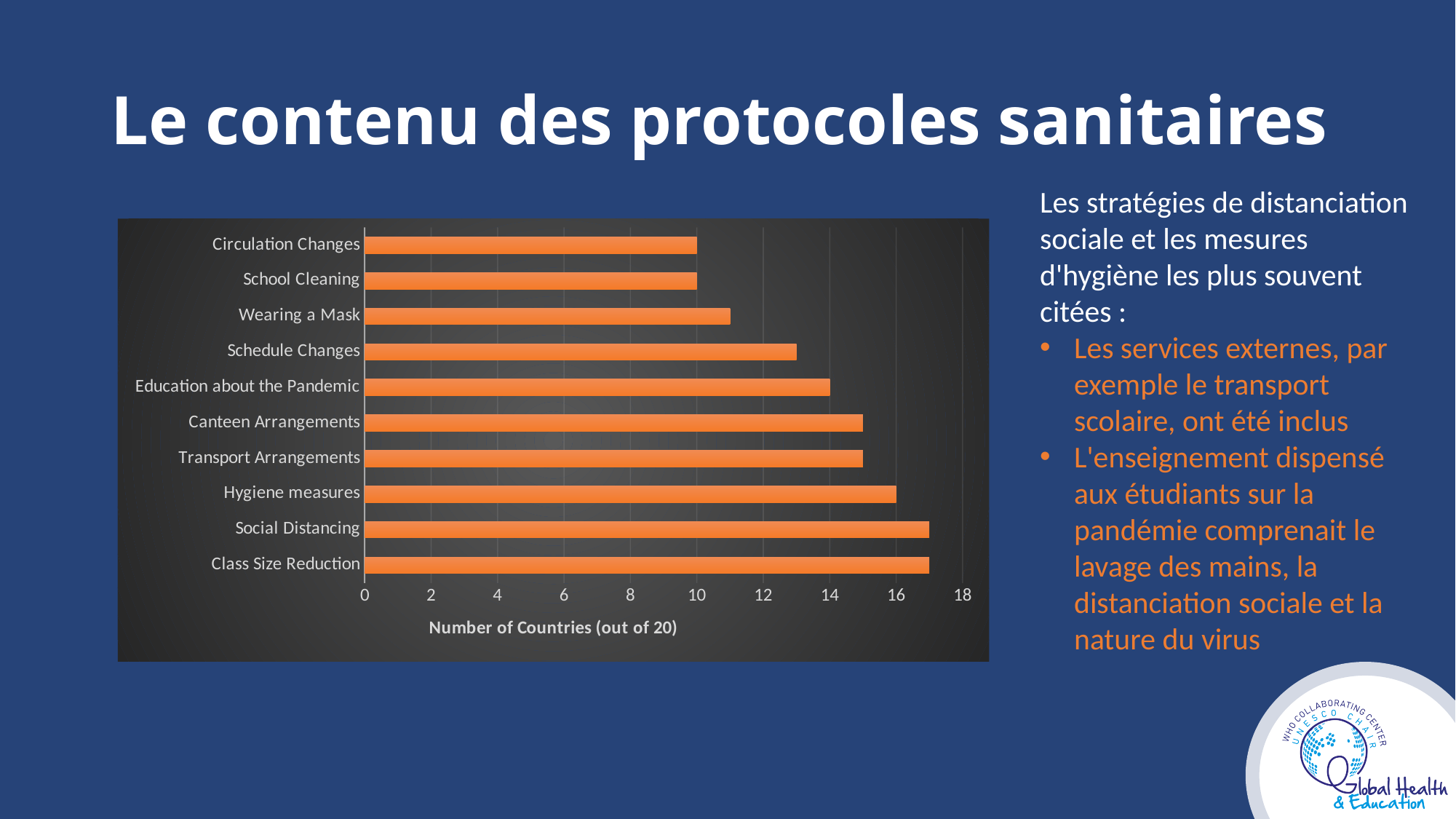
What is the value for School Cleaning on the chart? 10 Is the value for Canteen Arrangements greater or less than 14? greater How many categories are shown on the chart? 10 Is the value for Social Distancing greater or less than 16? greater What is the difference between the values for Hygiene measures and Circulation Changes? 6 Which has a larger value, Hygiene measures or Wearing a Mask? Hygiene measures Is the value for Wearing a Mask greater or less than 12? less What is the title of the horizontal axis of the chart? Number of Countries (out of 20) How many countries included Circulation Changes in their protocols, according to the chart? 10 What is the value for Education about the Pandemic on the chart? 14 What kind of chart is shown on the slide? bar chart What is the value for Hygiene measures on the chart? 16